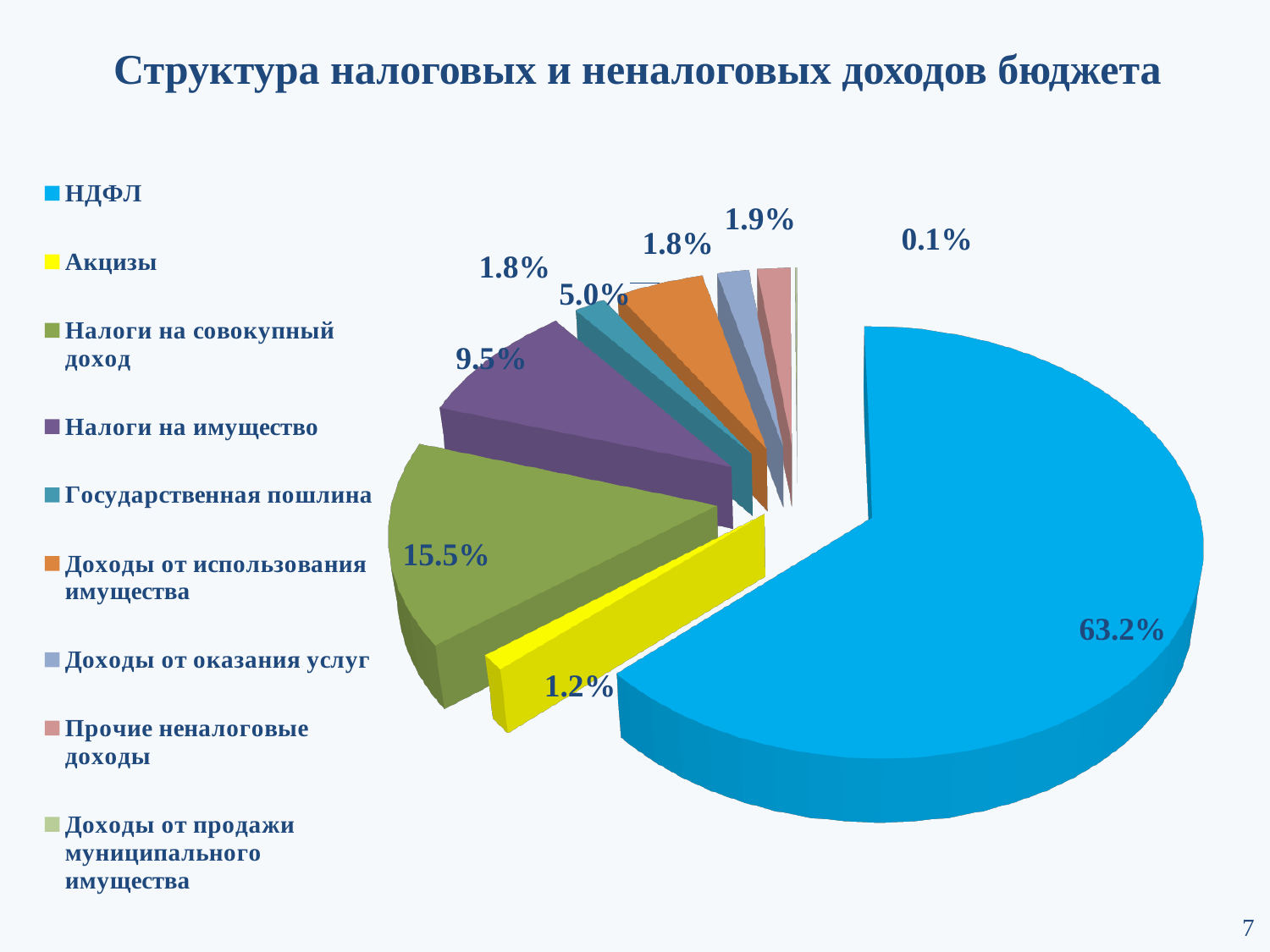
Which category has the smallest share of the pie? Доходы от продажи муниципального имущества Which is larger, the share of Налоги на имущество or the share of Государственная пошлина? Налоги на имущество What share of the pie does Государственная пошлина have? 1.8% What is the difference between the shares of НДФЛ and Налоги на совокупный доход? 47.7% How many categories does the legend list? 9 What type of chart is shown on the slide? pie chart Which category has the largest share of the pie? НДФЛ What share of the pie does Налоги на имущество have? 9.5% What share of the pie does НДФЛ have? 63.2% What share of the pie does Налоги на совокупный доход have? 15.5% What share of the pie does Акцизы have? 1.2% What share of the pie does Доходы от продажи муниципального имущества have? 0.1%